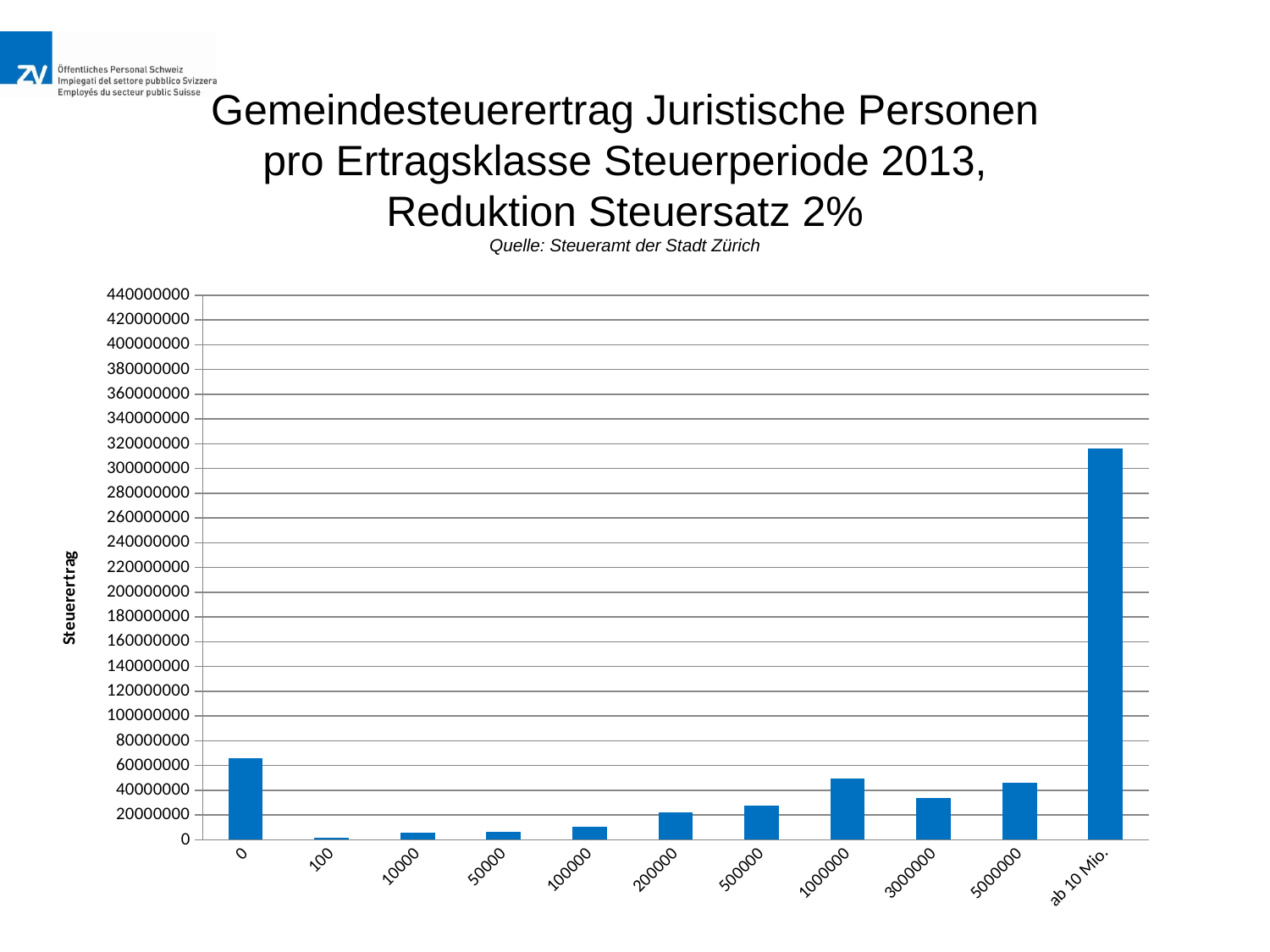
Which category has the lowest Steuerertrag? 100 How many categories (Ertragsklassen) are shown on the x axis? 11 Is the value for 'ab 10 Mio.' greater or less than 300000000? greater Which has the larger Steuerertrag, the category '0' or the category '1000000'? 0 Is the value for '0' greater or less than 60000000? greater Which category has the highest Steuerertrag? ab 10 Mio. What kind of chart is shown on the slide? bar chart Is the value for '200000' greater or less than 40000000? less Which has the larger Steuerertrag, the category '3000000' or the category '5000000'? 5000000 What source is given for the chart data? Steueramt der Stadt Zürich What is the label of the vertical axis? Steuerertrag